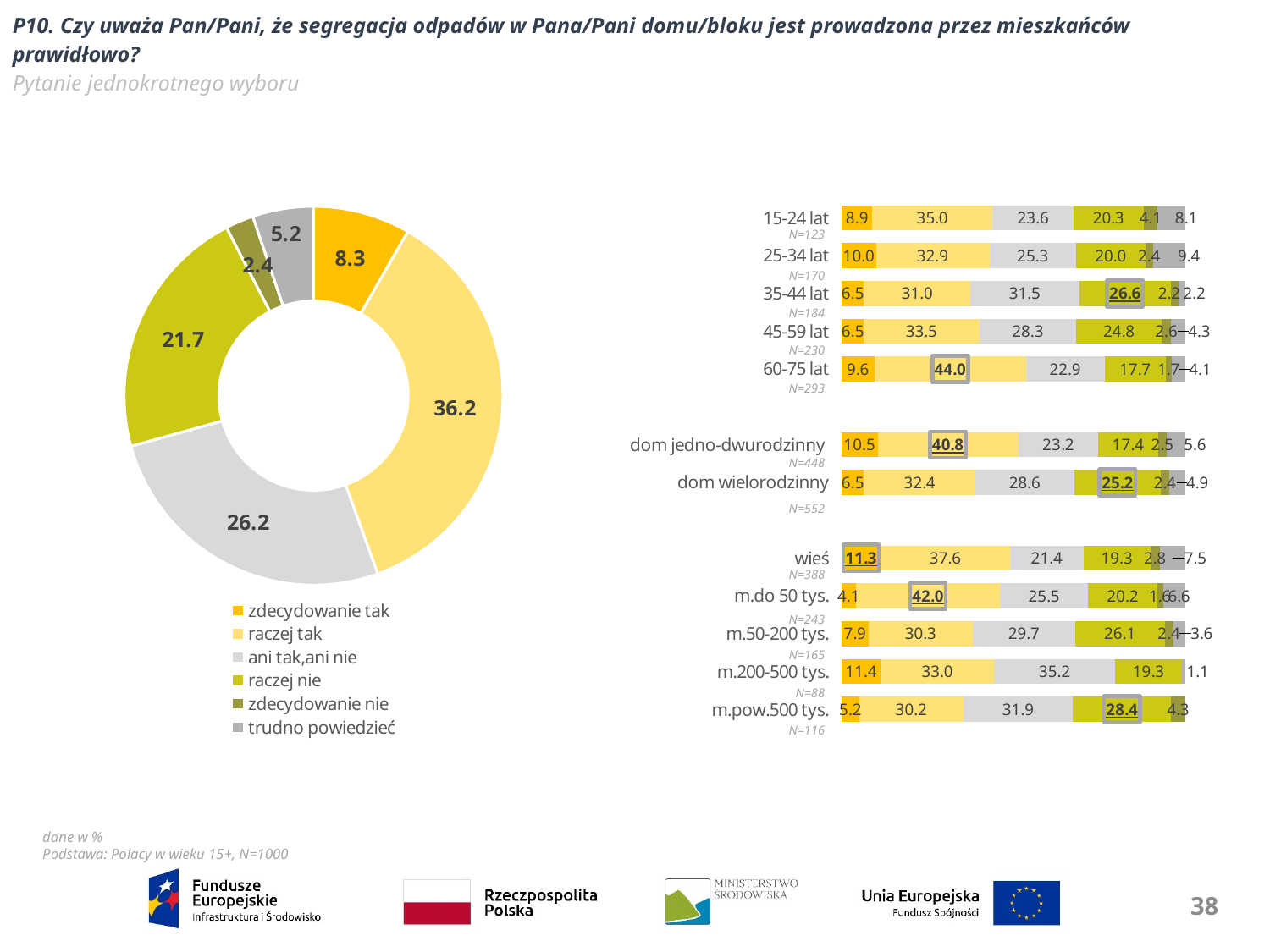
How many categories does the donut chart on the left show? 6 In the donut chart on the left, which category has the largest share? raczej tak In the stacked bar chart on the right, what is the 'raczej tak' value for the 60-75 lat group? 44.0 In the stacked bar chart on the right, what is the 'ani tak,ani nie' value for 'm.200-500 tys.'? 35.2 In the stacked bar chart on the right, which age group has the highest 'raczej tak' value? 60-75 lat What kind of chart is shown on the left of the slide? Donut (pie) chart In the donut chart on the left, what is the difference between 'raczej tak' and 'ani tak,ani nie'? 10.0 In the stacked bar chart on the right, which has the larger 'raczej nie' value: 'dom jedno-dwurodzinny' or 'dom wielorodzinny'? dom wielorodzinny In the donut chart on the left, what is the value for 'raczej tak'? 36.2 In the stacked bar chart on the right, what is the difference between the 'raczej tak' values for 60-75 lat and 15-24 lat? 9.0 In the stacked bar chart on the right, what is the 'zdecydowanie tak' value for 'wieś'? 11.3 In the donut chart on the left, which category has the smallest share? zdecydowanie nie